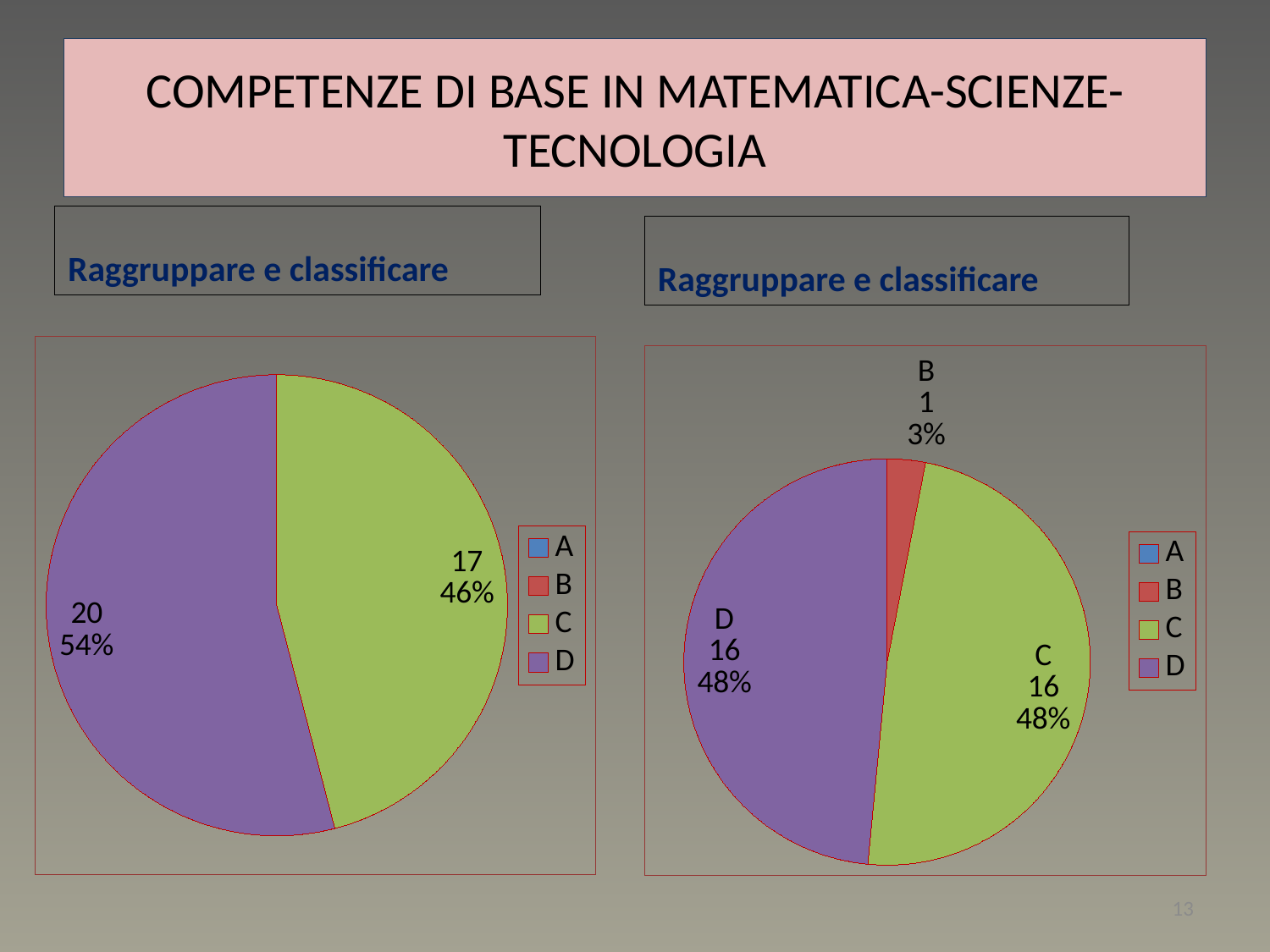
In the left pie chart, what is the difference between the values for D and C? 3 How many slices are shown in the right pie chart? 3 In the right pie chart, what is the value shown for category B? 1 What kind of chart is the left chart on the slide? Pie chart How many entries does the legend of the left chart list? 4 In the left pie chart, what is the value shown for category D? 20 In the left pie chart, what percentage share does category C have? 46% What title is shown above each of the two pie charts? Raggruppare e classificare In the right pie chart, what percentage share does category B have? 3% Which chart has the larger value for category D, the left chart or the right chart? The left chart In the left pie chart, which category has the largest slice? D In the right pie chart, which category has the smallest slice? B